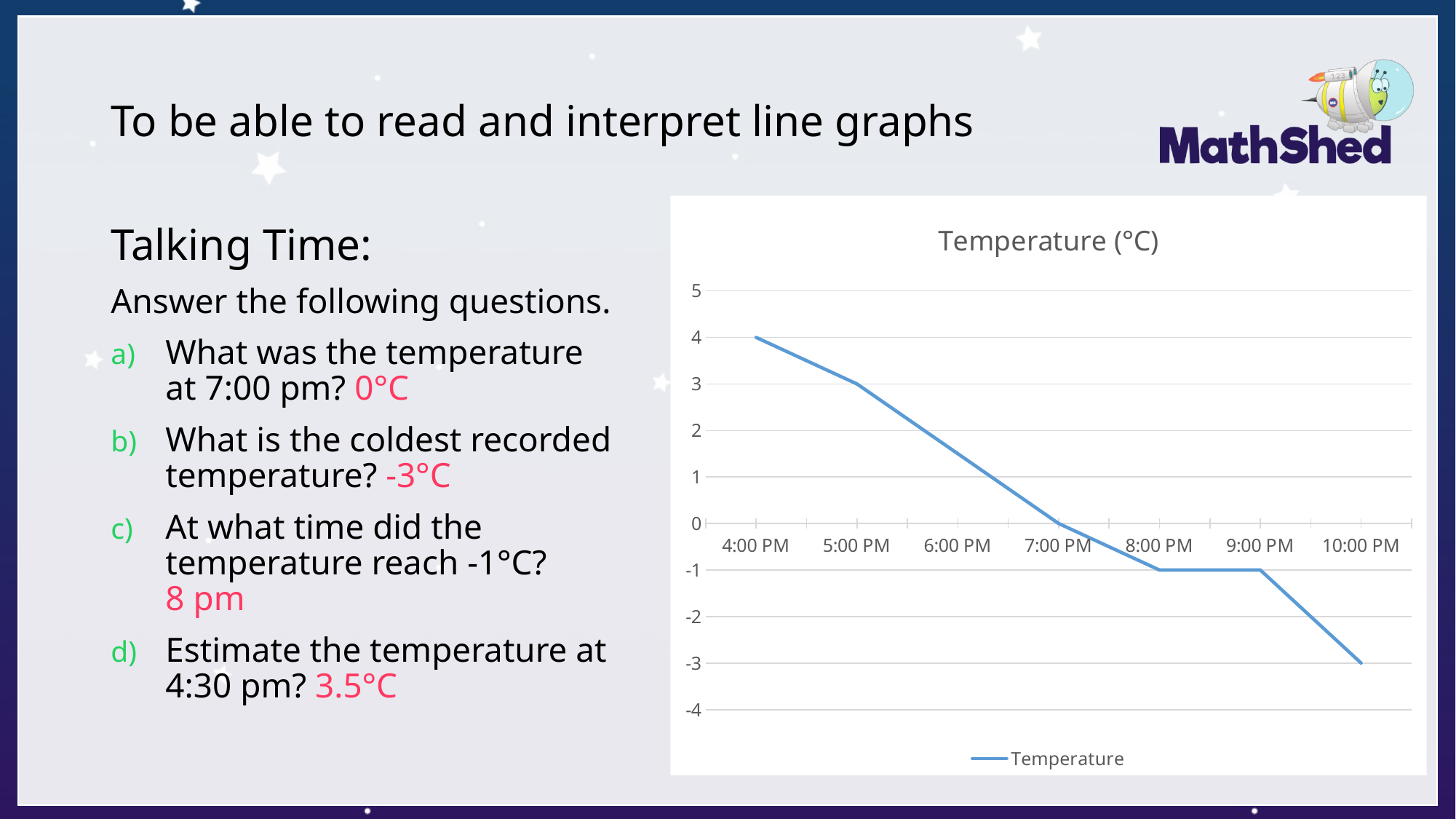
What kind of chart is shown on the slide? line chart What is the temperature at 4:00 PM? 4 At which time is the temperature highest? 4:00 PM How many series does the legend list? 1 What is the difference between the temperature at 4:00 PM and the temperature at 10:00 PM? 7 How many time points are plotted on the chart? 7 Is the temperature at 6:00 PM greater or less than 1? greater Which is higher, the temperature at 5:00 PM or at 8:00 PM? 5:00 PM What is the temperature at 7:00 PM? 0 At which time is the temperature lowest? 10:00 PM What is the temperature at 10:00 PM? -3 Does the temperature generally rise or fall from 4:00 PM to 10:00 PM? fall